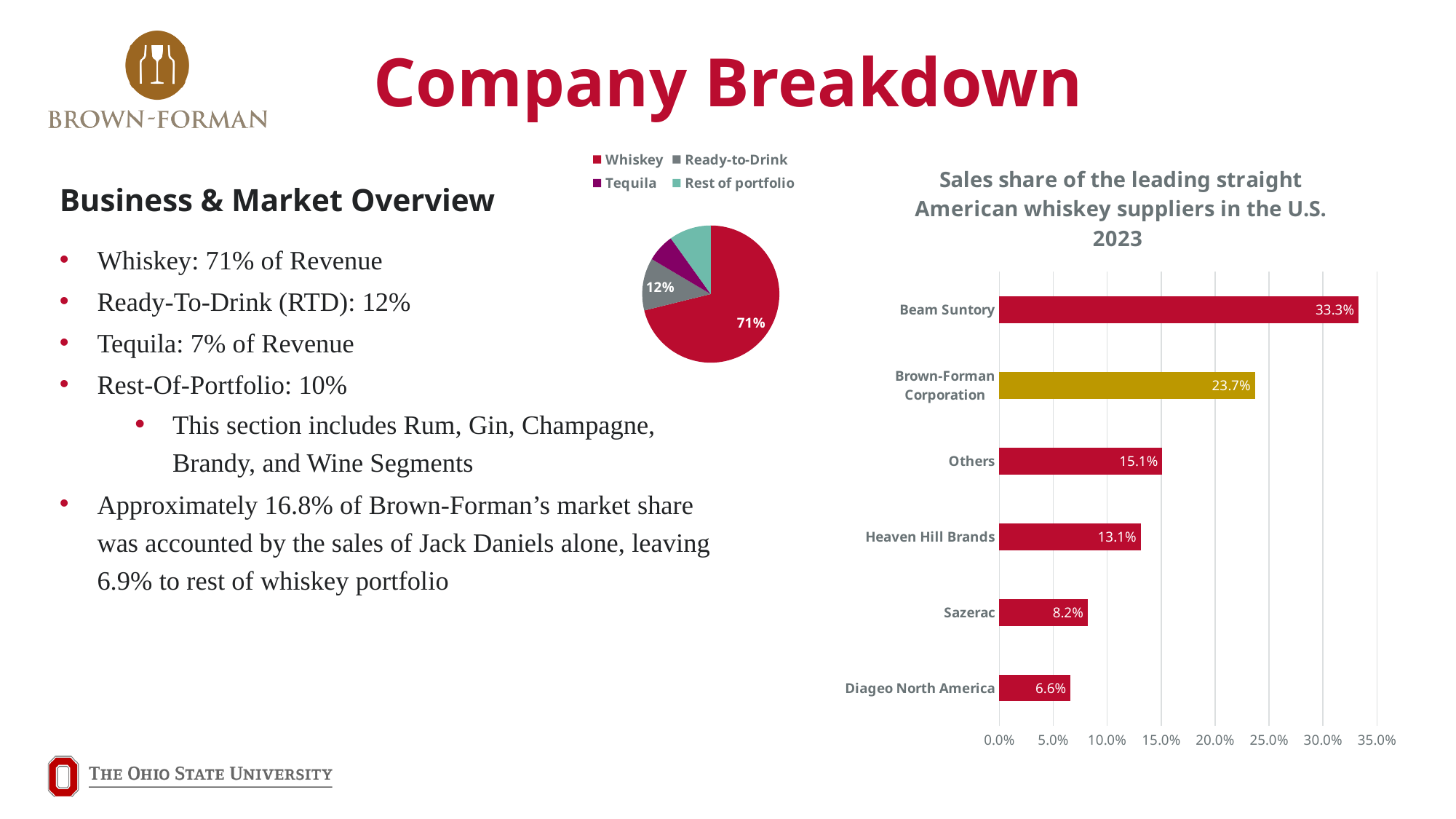
In the bar chart on the right, what is the value for Heaven Hill Brands? 13.1% In the pie chart in the middle of the slide, what share is labelled for Whiskey? 71% How many suppliers (categories) are shown in the bar chart on the right? 6 In the bar chart on the right, which is larger: the value for Sazerac or the value for Diageo North America? Sazerac How many entries does the legend of the pie chart list? 4 What kind of chart is the 'Sales share of the leading straight American whiskey suppliers in the U.S. 2023' chart? bar chart In the bar chart on the right, what is the difference between Beam Suntory's and Brown-Forman Corporation's sales shares? 9.6% In the bar chart titled 'Sales share of the leading straight American whiskey suppliers in the U.S. 2023', what is the value for Beam Suntory? 33.3% In the bar chart on the right, what is the sales share of Brown-Forman Corporation? 23.7% In the bar chart on the right, which supplier has the lowest sales share? Diageo North America In the bar chart on the right, which supplier has the highest sales share? Beam Suntory In the pie chart in the middle of the slide, what share is labelled for Ready-to-Drink? 12%